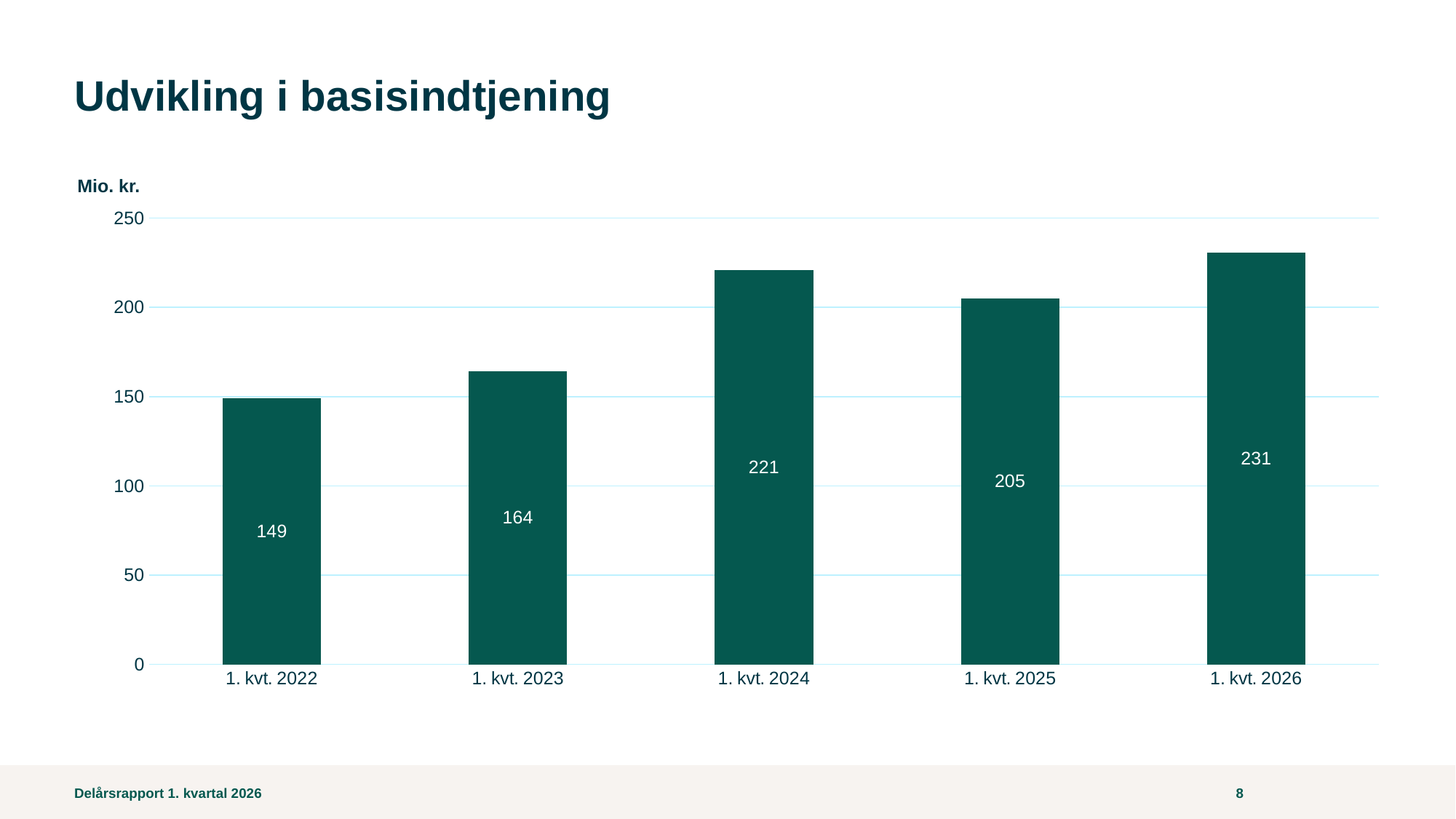
What is the difference between the values for 1. kvt. 2026 and 1. kvt. 2025? 26 Is the value for 1. kvt. 2023 greater or less than 200? less What is the value for 1. kvt. 2024? 221 Which quarter has the highest value? 1. kvt. 2026 What is the difference between the values for 1. kvt. 2023 and 1. kvt. 2022? 15 What is the value for 1. kvt. 2025? 205 What kind of chart is shown on the slide? Bar chart What unit is shown on the y axis label of the chart? Mio. kr. What is the value for 1. kvt. 2022? 149 Which quarter has the lowest value? 1. kvt. 2022 How many bars are shown in the chart? 5 Which is larger, the value for 1. kvt. 2024 or 1. kvt. 2025? 1. kvt. 2024